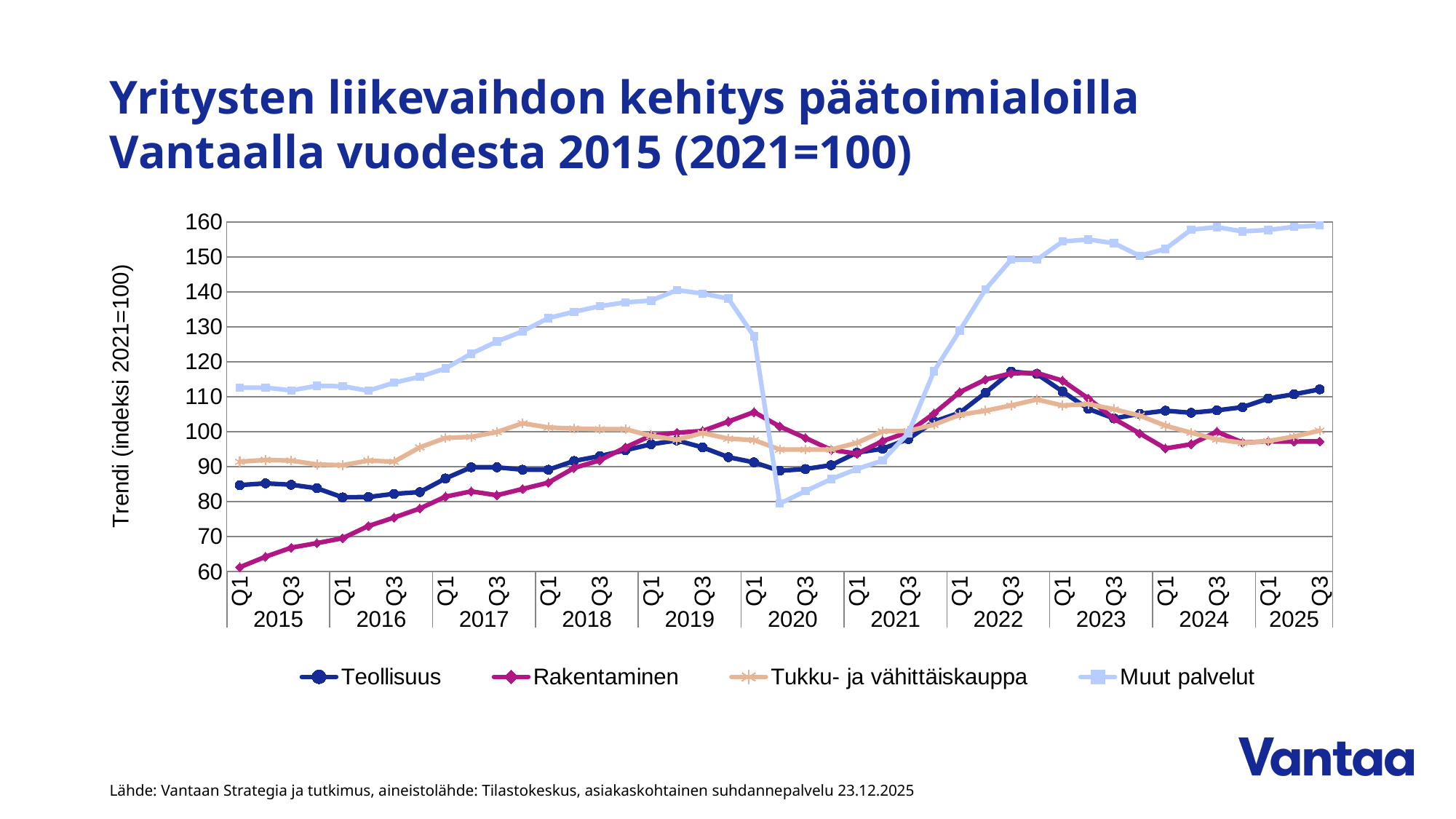
How many series does the legend list? 4 Is the value for Muut palvelut in Q3 2025 greater or less than 150? greater Which series has the lowest value in Q1 2015? Rakentaminen Which series are listed in the legend? Teollisuus, Rakentaminen, Tukku- ja vähittäiskauppa, Muut palvelut Is the value for Muut palvelut in Q2 2020 greater or less than 90? less In Q3 2025, which series has the higher value, Teollisuus or Rakentaminen? Teollisuus Does the Rakentaminen series rise or fall from Q1 2015 to Q3 2019? rise Which series has the highest value in Q3 2025? Muut palvelut Is the value for Teollisuus in Q3 2022 greater or less than 110? greater What is the title of the vertical axis? Trendi (indeksi 2021=100) What kind of chart is shown on the slide? line chart